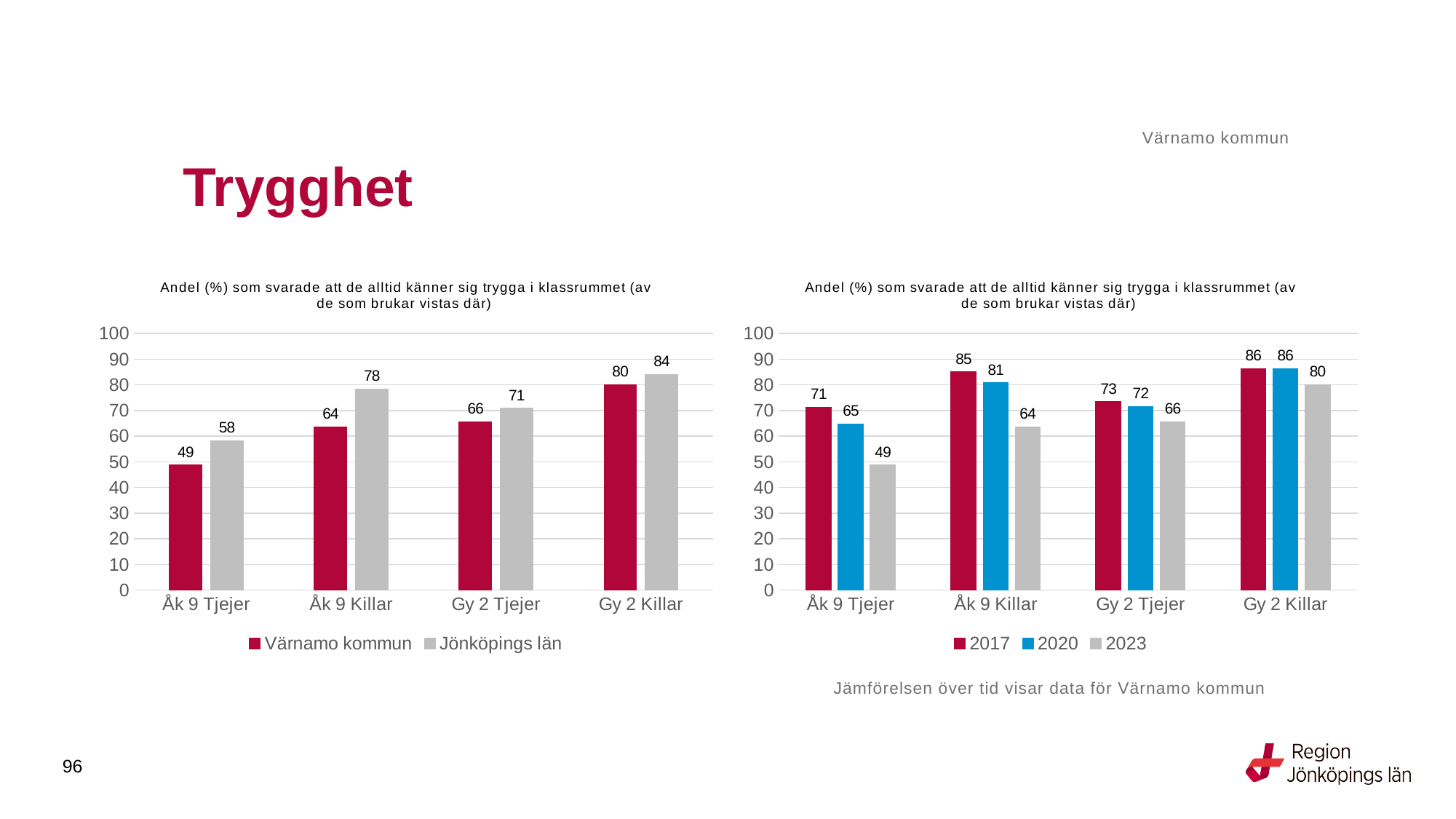
In the left chart, what is the value for Jönköpings län for Åk 9 Killar? 78 In the left chart, how many series does the legend list? 2 In the right chart, which category has the lowest value for 2020? Åk 9 Tjejer In the left chart, which category has the highest value for Värnamo kommun? Gy 2 Killar In the right chart, what is the value for 2023 for Åk 9 Tjejer? 49 In the right chart, what is the difference between 2017 and 2023 for Åk 9 Killar? 21 What kind of chart is the right chart? Bar chart In the right chart, what is the value for 2017 for Gy 2 Tjejer? 73 In the right chart, how many series does the legend list? 3 In the left chart, which is larger for Gy 2 Tjejer: Värnamo kommun or Jönköpings län? Jönköpings län In the left chart, what is the difference between Jönköpings län and Värnamo kommun for Åk 9 Killar? 14 In the left chart, what is the value for Värnamo kommun for Åk 9 Tjejer? 49